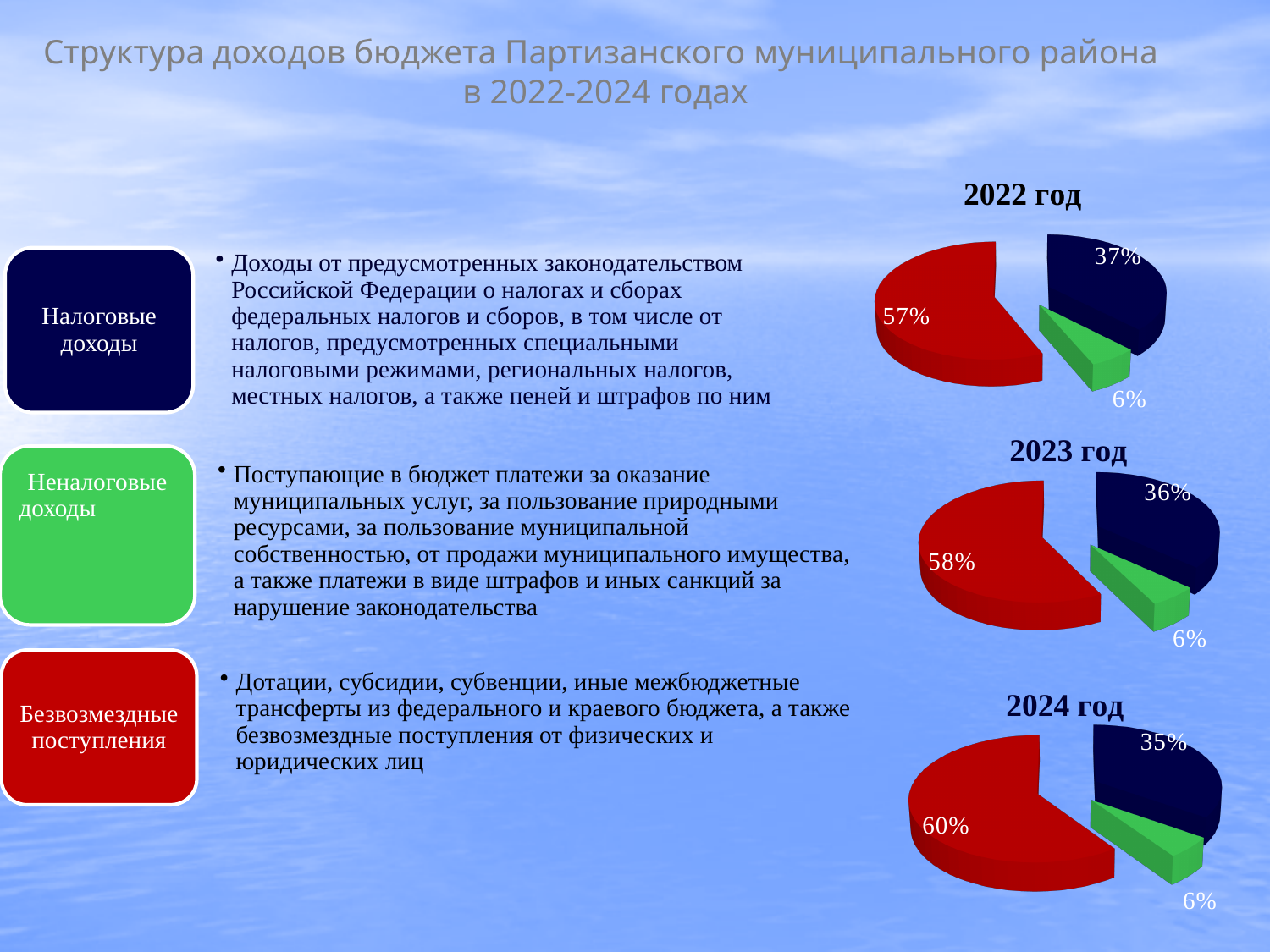
How many slices does each pie chart on the slide have? 3 In the 2024 год pie chart, what share is shown for the green slice (Неналоговые доходы)? 6% In the 2022 год pie chart, what share is shown for the red slice (Безвозмездные поступления)? 57% What type of chart is used to show the 2022 год budget structure? Pie chart Across the 2022, 2023 and 2024 charts, does the share of the red slice (Безвозмездные поступления) rise or fall? Rises In the 2024 год pie chart, what share is shown for the red slice (Безвозмездные поступления)? 60% In the 2023 год pie chart, by how many percentage points does the red slice exceed the dark blue slice? 22 percentage points Is the red slice (Безвозмездные поступления) larger in the 2022 год chart or the 2024 год chart? 2024 год In the 2023 год pie chart, what share is shown for the dark blue slice (Налоговые доходы)? 36% In the 2022 год pie chart, which category has the smallest slice? Неналоговые доходы (green) In the 2024 год pie chart, which category has the largest slice? Безвозмездные поступления (red) How many pie charts are shown on the slide? 3